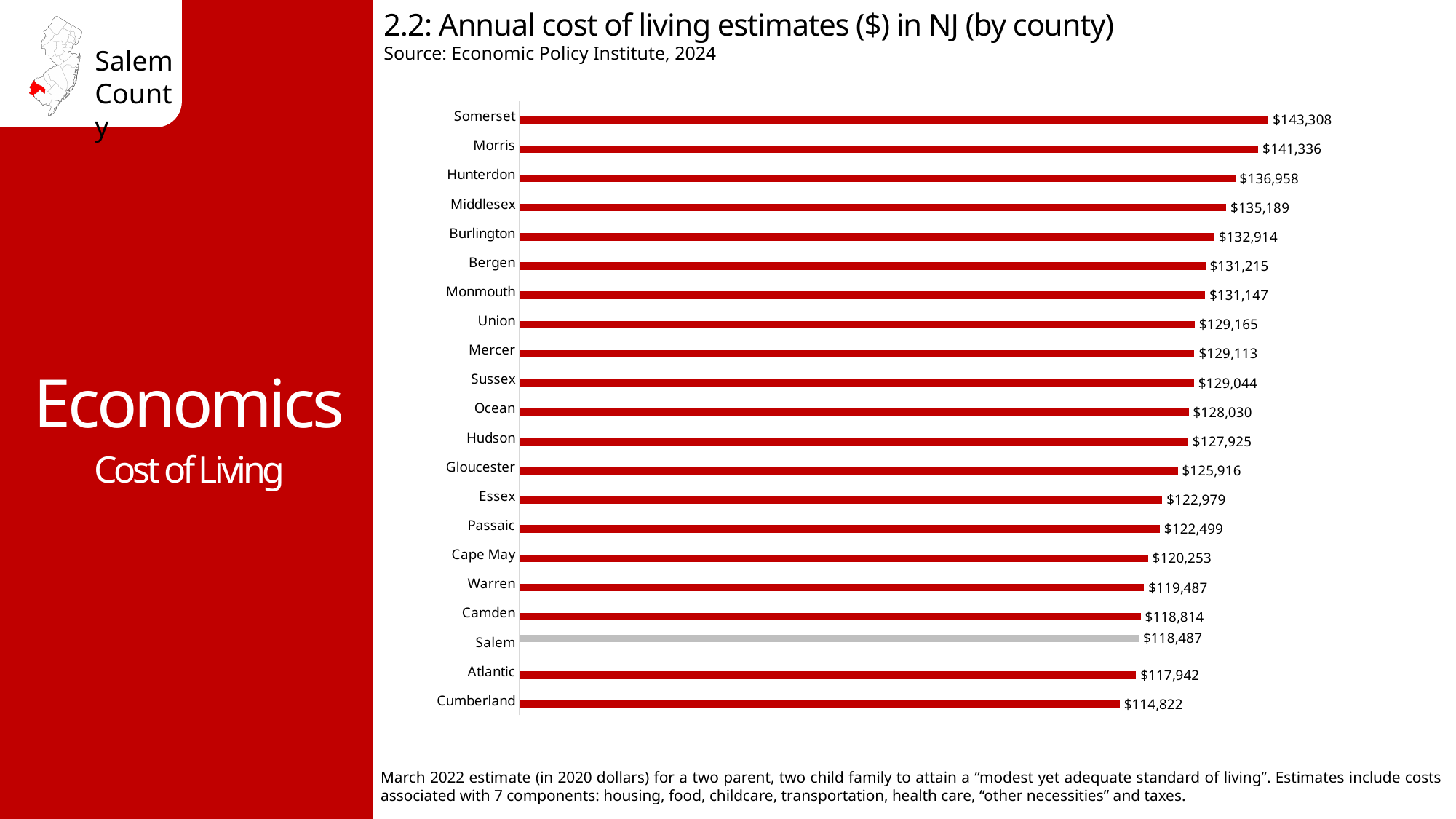
How much higher is Salem's cost of living estimate than Cumberland's? $3,665 What is the difference between the cost of living estimates for Somerset and Cumberland? $28,486 How many counties are shown in the chart? 21 What is the annual cost of living estimate for Salem County? $118,487 What is the annual cost of living estimate for Gloucester County? $125,916 Which has a higher cost of living estimate, Morris or Hunterdon? Morris Which county has the highest annual cost of living estimate? Somerset Which county has the lowest annual cost of living estimate? Cumberland What type of chart is used on this slide? Bar chart What is the annual cost of living estimate for Somerset County? $143,308 Which county's bar is shown in gray instead of red? Salem Which has a higher cost of living estimate, Camden or Atlantic? Camden